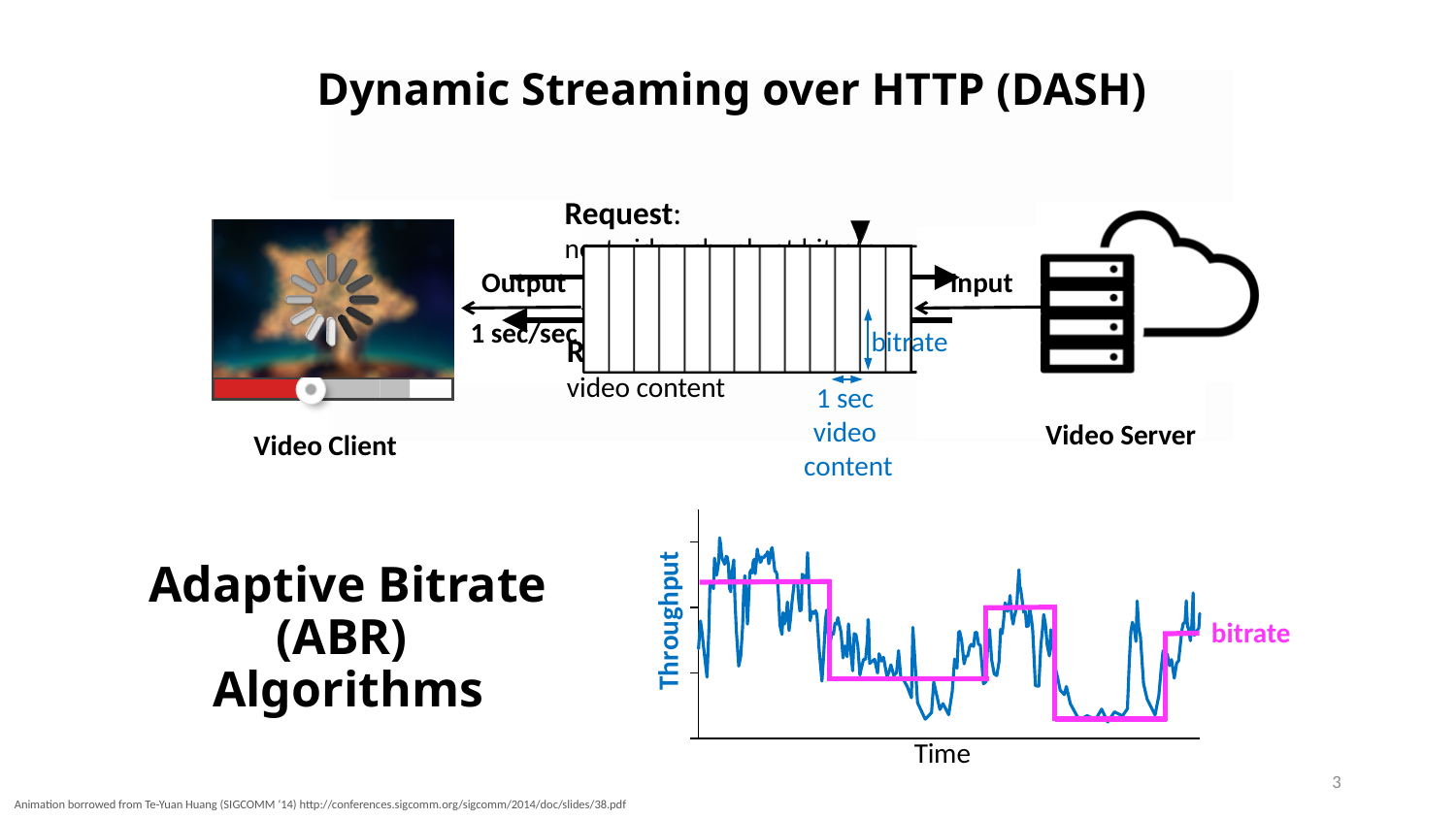
On the Throughput chart, which segment of the bitrate step line is the highest? the first segment How many constant-level segments does the bitrate step line have on the Throughput chart? 5 On the Throughput chart, which segment of the bitrate step line is the lowest? the fourth segment What kind of chart is shown at the bottom right of the slide? line chart What is the label on the vertical axis of the Throughput chart? Throughput On the Throughput chart, does the bitrate step line overall rise or fall from the left end to the right end of the time axis? fall On the Throughput chart, is the bitrate level at the start of the time axis higher or lower than at the end? higher How many lines are plotted on the Throughput chart? 2 On the Throughput chart, is the third bitrate segment higher or lower than the second bitrate segment? higher On the Throughput chart, what does the magenta step line represent? bitrate What is the label on the horizontal axis of the Throughput chart? Time